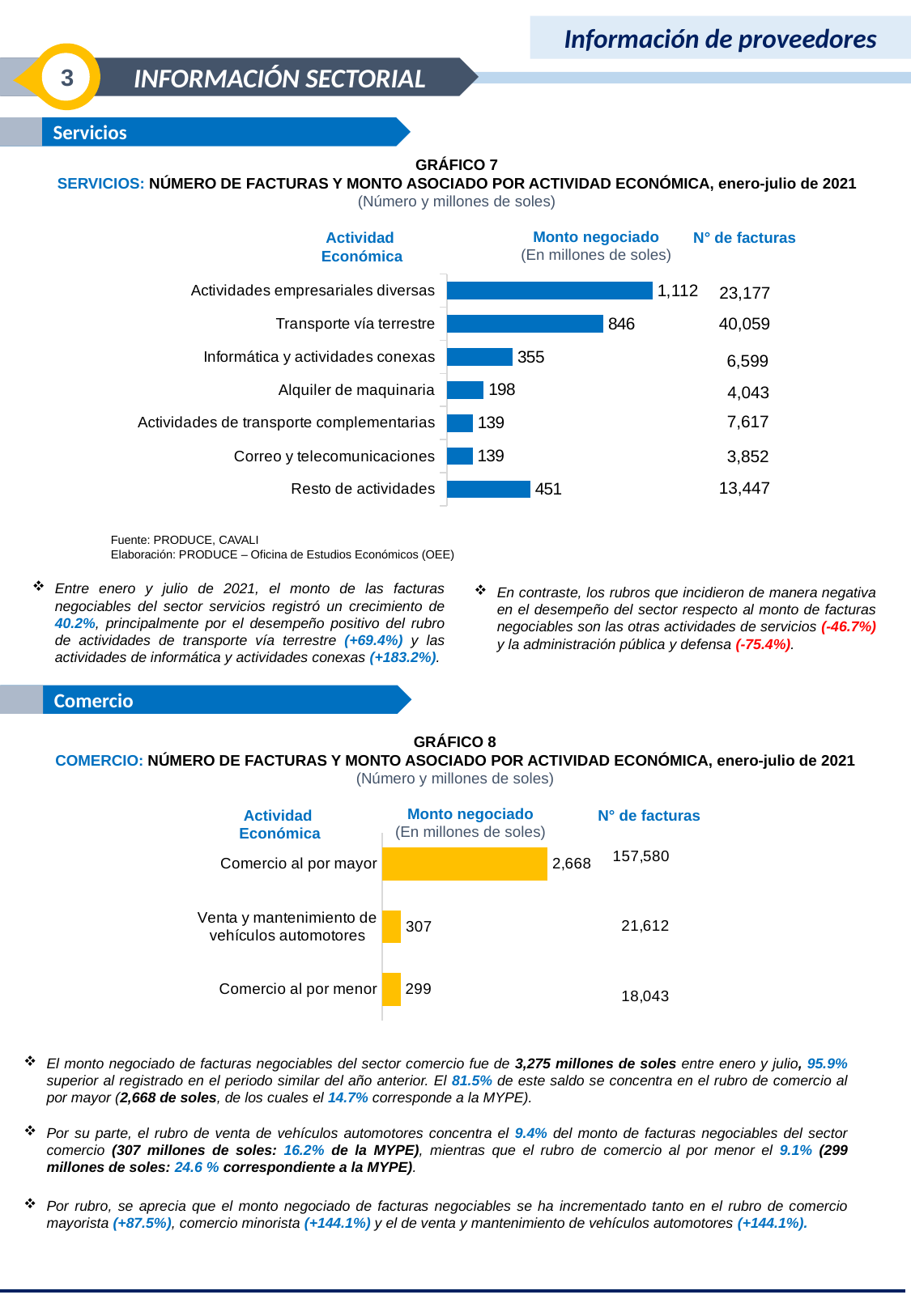
What colour are the bars in Gráfico 8 (Comercio)? Yellow In Gráfico 7 (Servicios), what is the monto negociado for Transporte vía terrestre? 846 What type of chart is Gráfico 8 (Comercio)? Bar chart In Gráfico 7 (Servicios), which has a larger monto negociado, Informática y actividades conexas or Resto de actividades? Resto de actividades In Gráfico 7 (Servicios), how many actividades económicas are plotted? 7 In Gráfico 8 (Comercio), which actividad económica has the lowest monto negociado? Comercio al por menor In Gráfico 8 (Comercio), what is the monto negociado for Comercio al por mayor? 2,668 In Gráfico 7 (Servicios), what is the monto negociado for Alquiler de maquinaria? 198 In Gráfico 8 (Comercio), what is the N° de facturas for Venta y mantenimiento de vehículos automotores? 21,612 In Gráfico 7 (Servicios), which actividad económica has the highest monto negociado? Actividades empresariales diversas In Gráfico 7 (Servicios), what is the N° de facturas for Transporte vía terrestre? 40,059 In Gráfico 7 (Servicios), what is the difference in monto negociado between Actividades empresariales diversas and Transporte vía terrestre? 266